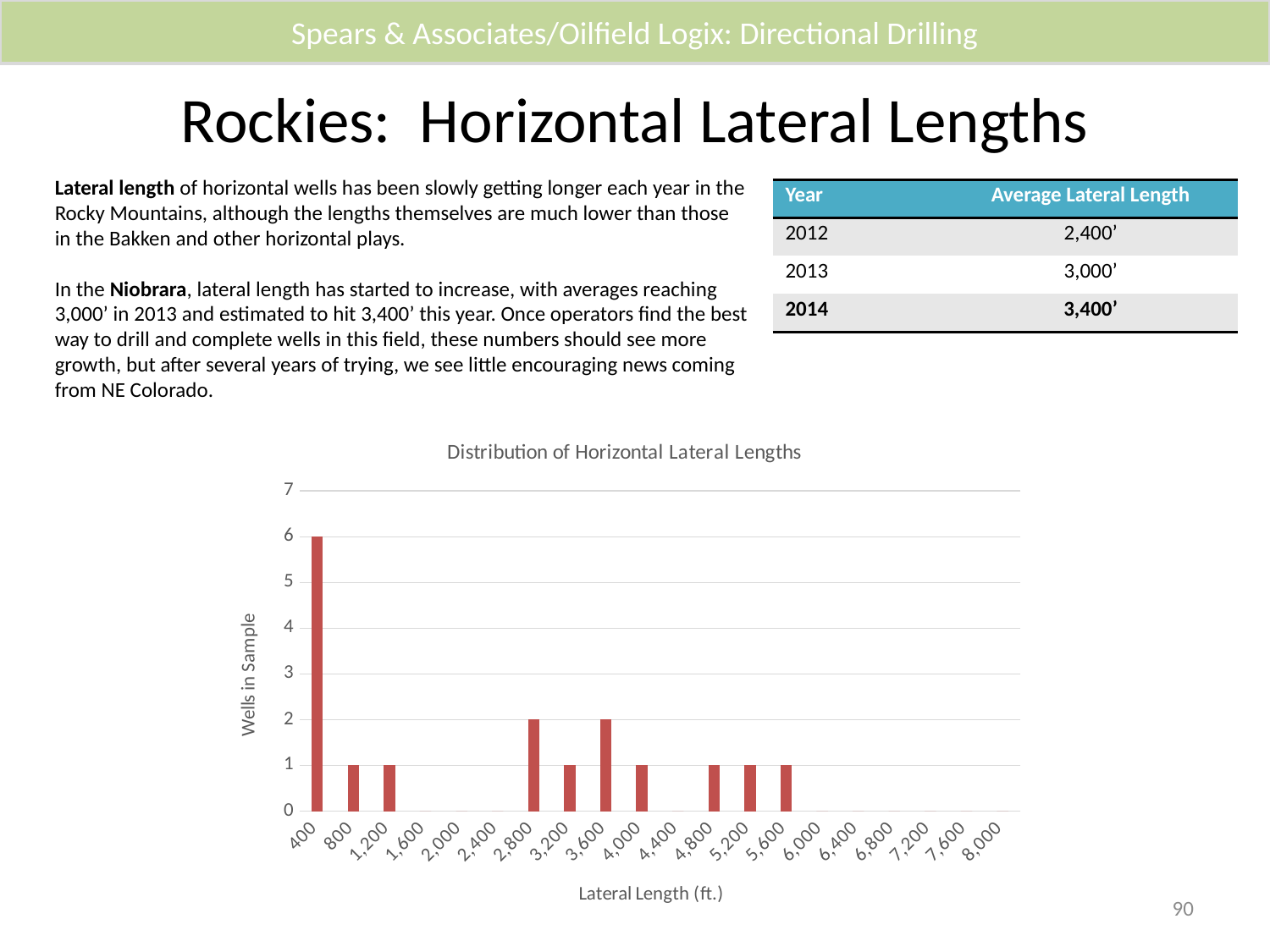
How many lateral length categories are shown on the x axis of the chart? 20 How many wells in the sample have a lateral length of 5,200 ft? 1 What type of chart is shown on the slide? Bar chart What is the label of the y axis of the chart? Wells in Sample How many wells in the sample have a lateral length of 3,600 ft? 2 Which has more wells in the sample: the 3,600 ft category or the 4,000 ft category? 3,600 Is the value for the 400 ft category greater or less than 5? greater How many wells in the sample have a lateral length of 2,800 ft? 2 What is the difference in wells in sample between the 400 ft category and the 2,800 ft category? 4 Which lateral length category has the highest number of wells in the sample? 400 How many wells in the sample have a lateral length of 400 ft? 6 What is the title of the chart? Distribution of Horizontal Lateral Lengths